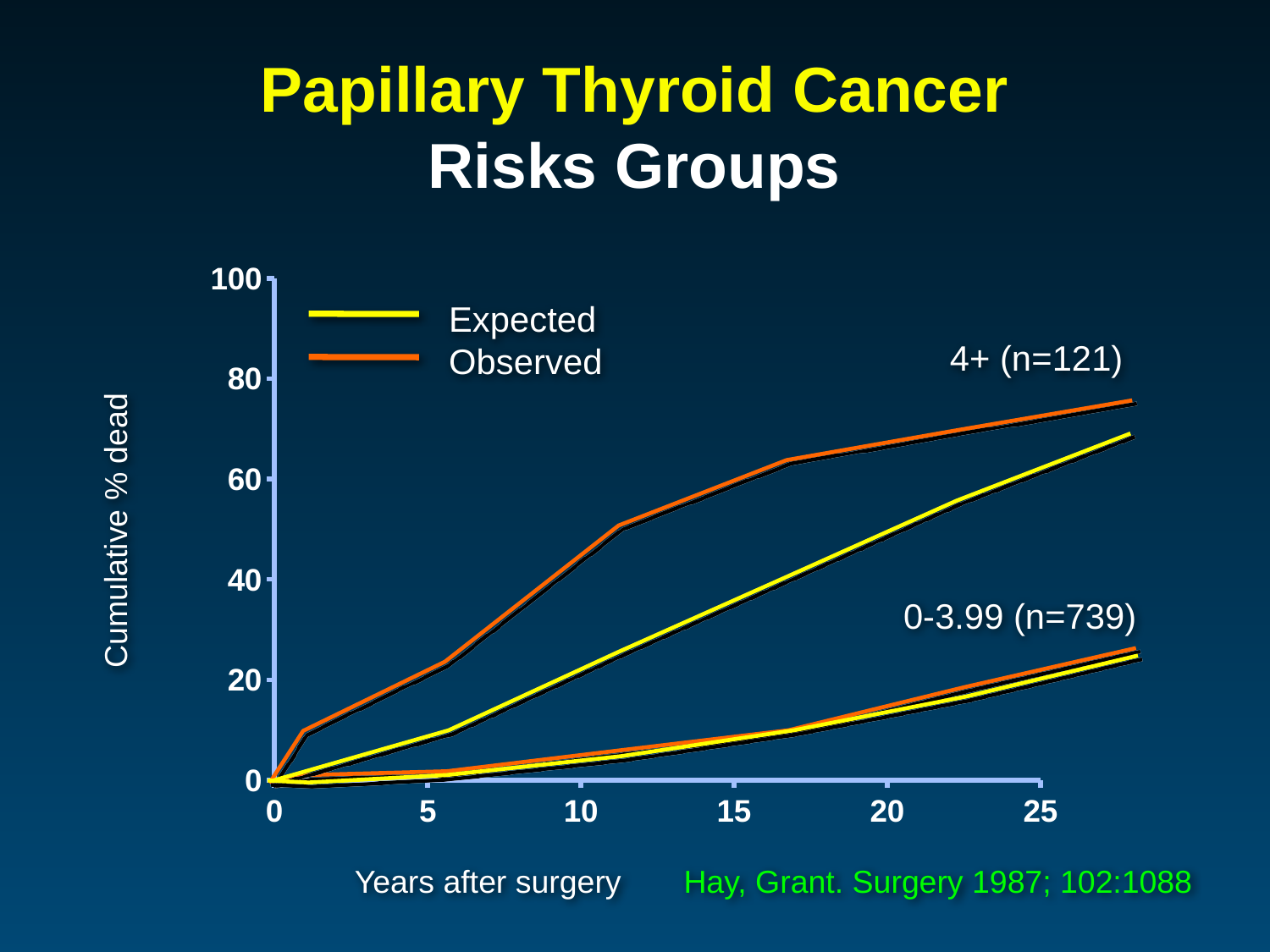
How many risk groups are plotted on the chart? 2 What is the label of the y axis? Cumulative % dead At 25 years after surgery, which group has the higher Observed cumulative % dead: 4+ or 0-3.99? 4+ Is the Observed value for the 4+ group at 10 years after surgery greater or less than 40? greater Is the Observed value for the 0-3.99 group at 25 years after surgery greater or less than 40? less How many series does the legend list? 2 Is the Observed value for the 4+ group at 25 years after surgery greater or less than 60? greater What kind of chart is shown on the slide? line chart At 10 years after surgery, which is larger for the 4+ group: the Observed or the Expected cumulative % dead? Observed What are the two series named in the legend? Expected and Observed Do the cumulative % dead lines rise or fall as years after surgery increase? rise